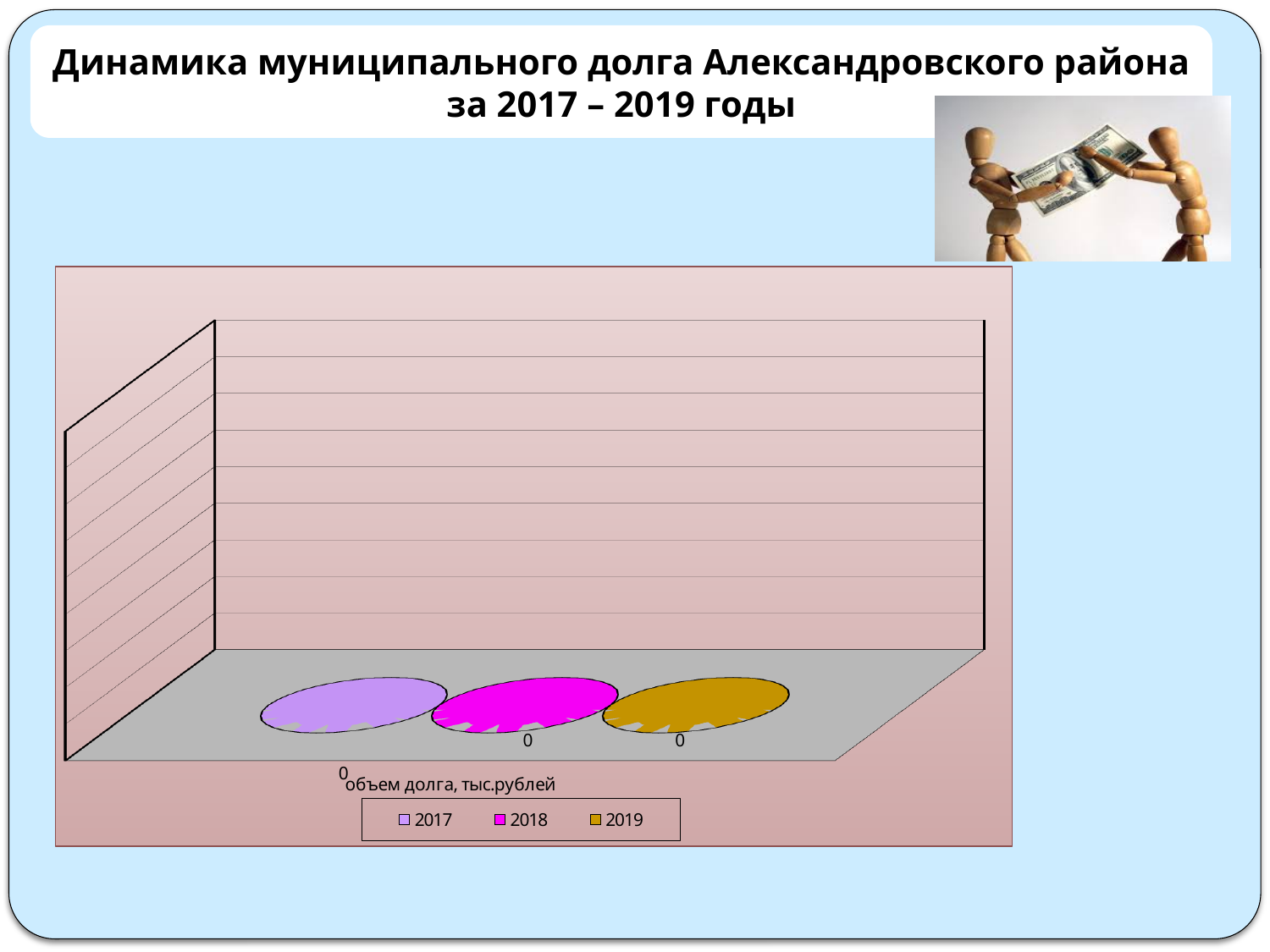
What is the total of the values for 2017, 2018 and 2019? 0 How many series does the legend list? 3 What is the difference between the values for 2019 and 2017? 0 How many categories are shown on the x axis of the chart? 1 What is the value for 2017 in the chart? 0 Which series is shown in magenta in the legend? 2018 What is the value for 2018 in the chart? 0 What is the label of the category on the x axis? объем долга, тыс.рублей What kind of chart is shown on the slide? bar chart What is the value for 2019 in the chart? 0